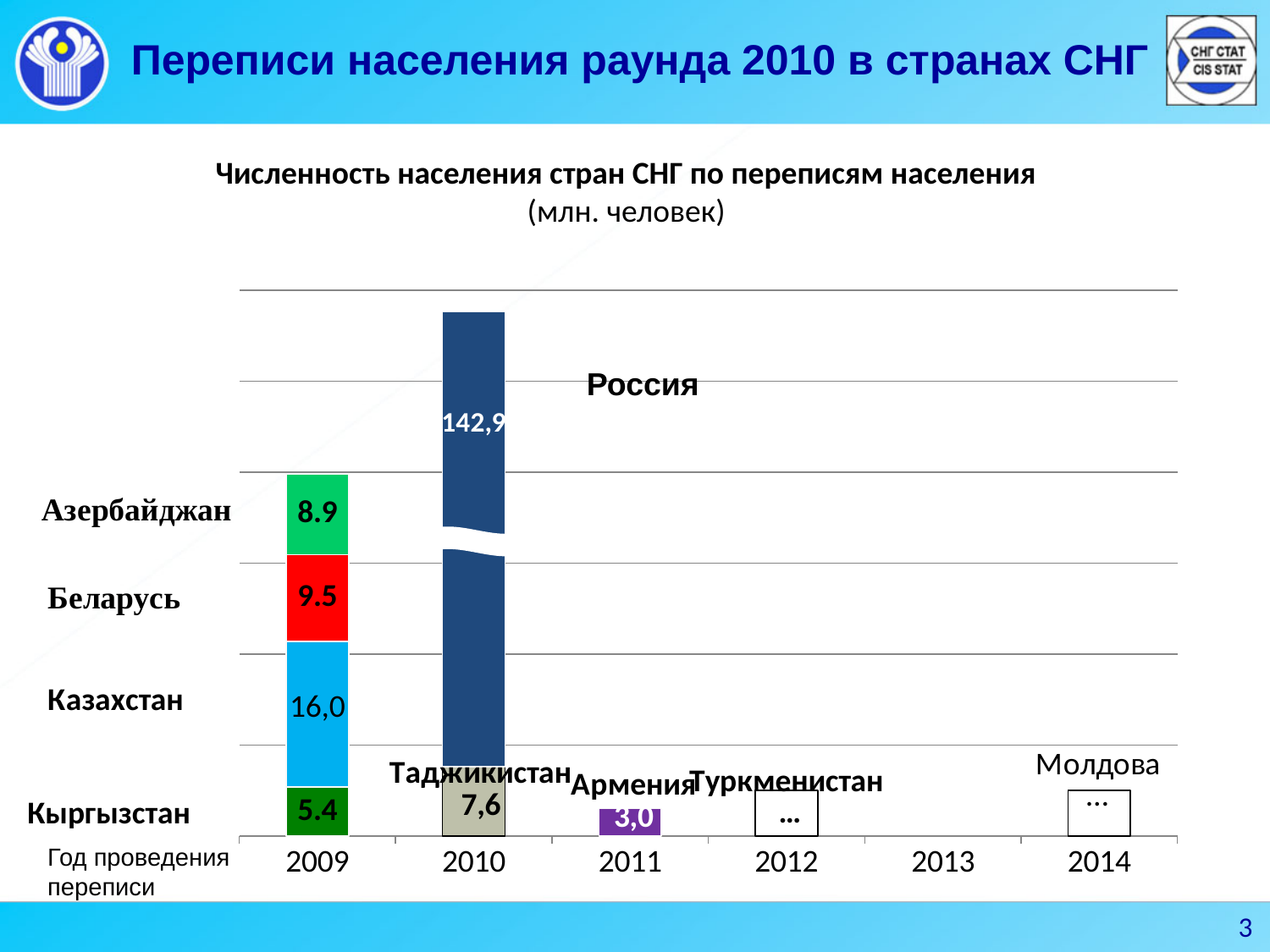
Which is larger, the value for Казахстан or the value for Кыргызстан? Казахстан What is the population value shown for Таджикистан in 2010? 7,6 What kind of chart is shown on the slide? Stacked bar chart What is the population value shown for Армения in 2011? 3,0 Among the countries with a numeric label, which has the smallest population value? Армения In what units are the population values given, according to the chart title? млн. человек What is the difference between the values for Беларусь and Азербайджан? 0.6 How many census years are shown on the x axis? 6 What is the population value shown for Беларусь? 9.5 Which country has the largest population value on the chart? Россия What is the population value shown for Россия in the 2010 bar? 142,9 What is the population value shown for Казахстан in the 2009 bar? 16,0